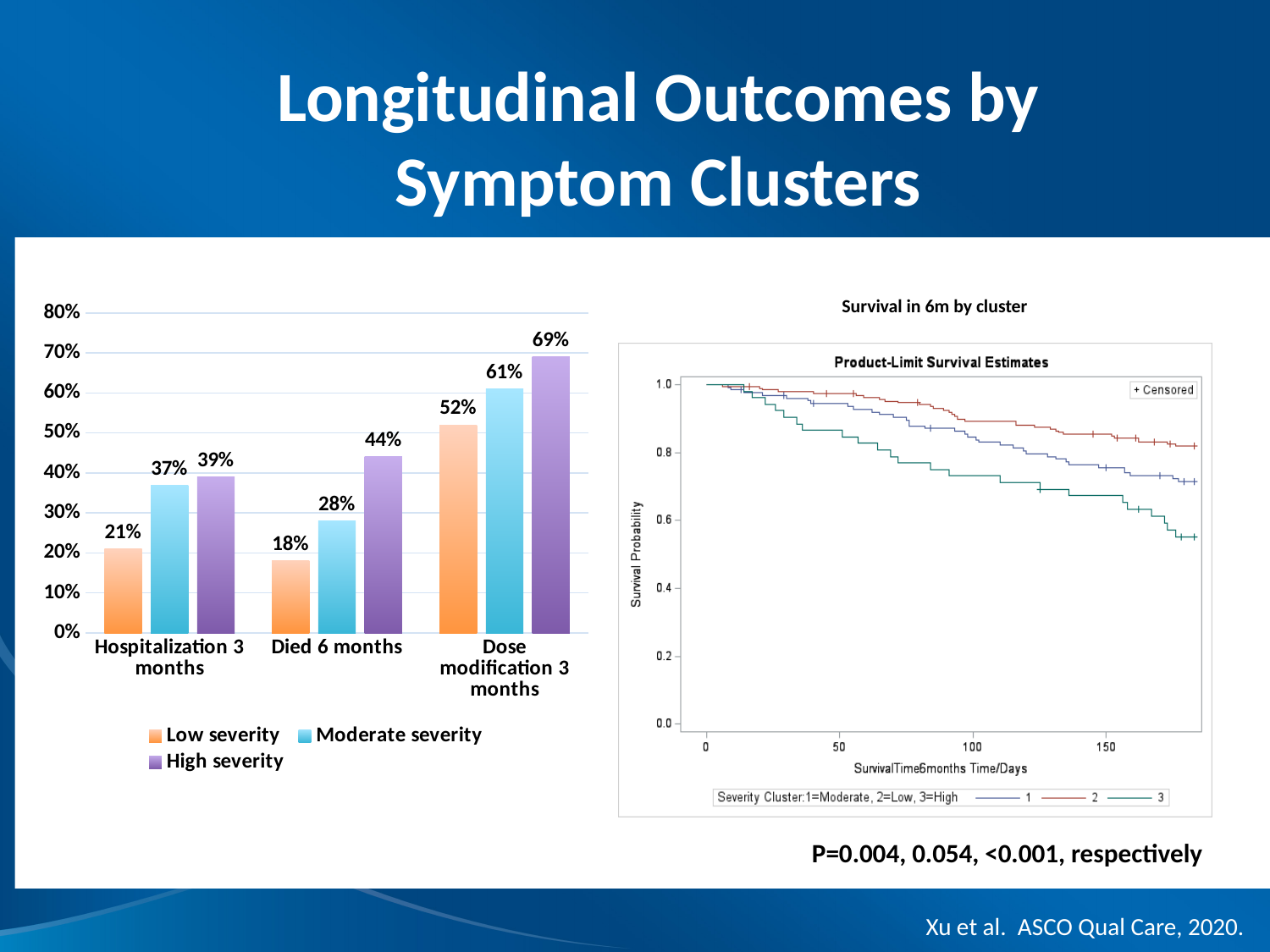
In the bar chart on the left, what is the value for Low severity in the Died 6 months category? 18% In the bar chart on the left, what is the difference between the High severity and Low severity values for Dose modification 3 months? 17% In the bar chart on the left, which severity group has the lowest value for Hospitalization 3 months? Low severity In the survival chart on the right, what is the label of the y axis? Survival Probability What kind of chart is shown on the left side of the slide? Bar chart In the bar chart on the left, how many categories are shown on the x axis? 3 In the bar chart on the left, how many series does the legend list? 3 In the survival chart on the right, is the survival probability for cluster 3 at 150 days greater or less than 0.8? less In the bar chart on the left, which is larger: the Moderate severity value for Died 6 months or the Moderate severity value for Hospitalization 3 months? Hospitalization 3 months In the bar chart on the left, what is the value for Moderate severity in the Hospitalization 3 months category? 37% In the bar chart on the left, which severity group has the highest value for Died 6 months? High severity In the bar chart on the left, what is the value for High severity in the Dose modification 3 months category? 69%